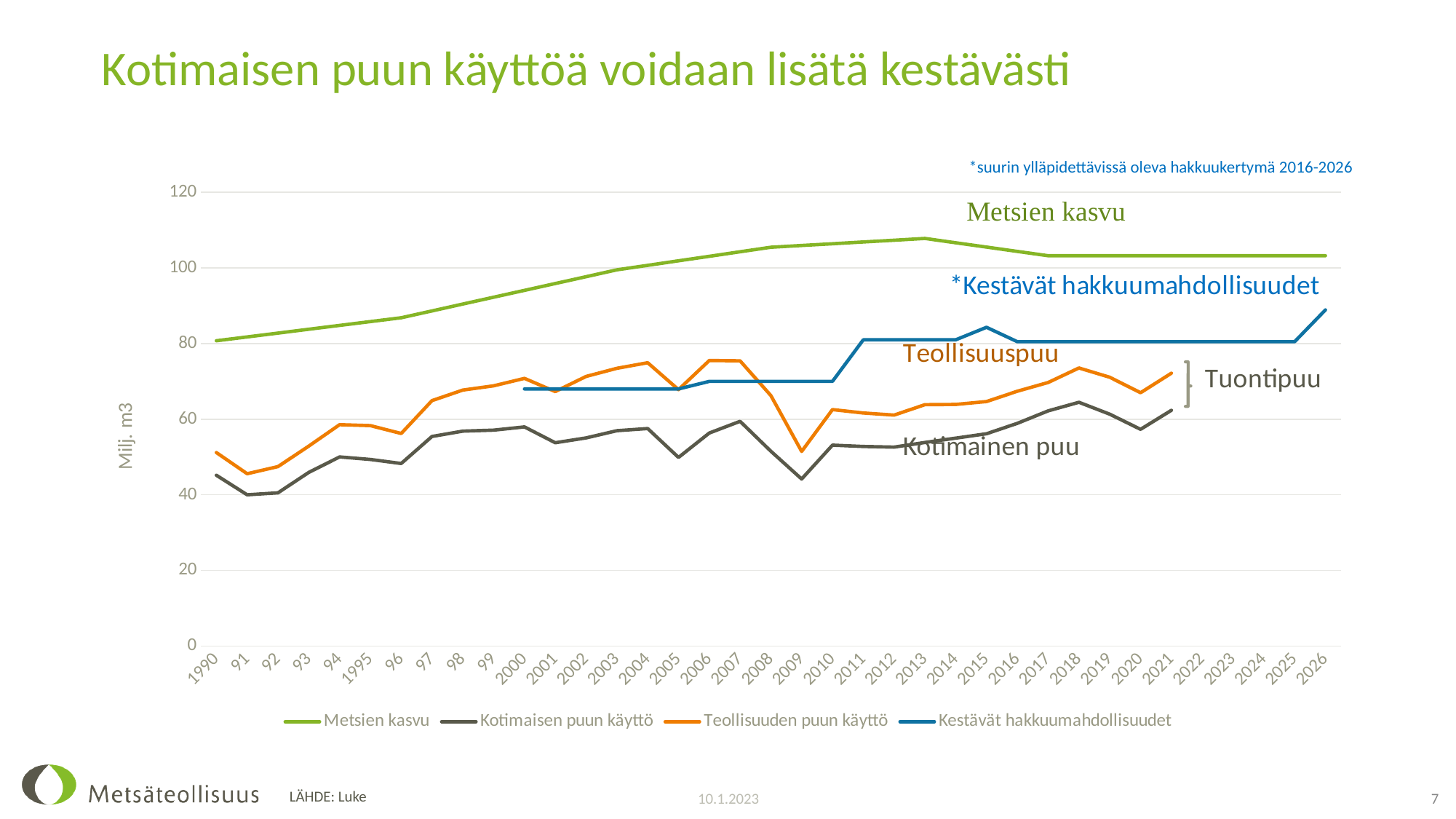
Does Metsien kasvu rise or fall from 1990 to 2013? rise In 2015, which is higher: Metsien kasvu or Kestävät hakkuumahdollisuudet? Metsien kasvu Is the value for Metsien kasvu in 2026 greater or less than 100? greater Is the value for Kotimaisen puun käyttö in 2009 greater or less than 60? less Is the value for Teollisuuden puun käyttö in 2009 greater or less than 60? less How many series does the legend list? 4 In 2021, which is higher: Teollisuuden puun käyttö or Kotimaisen puun käyttö? Teollisuuden puun käyttö Which series is drawn in green according to the legend? Metsien kasvu In which year is Teollisuuden puun käyttö at its lowest? 1991 What is the label on the vertical axis? Milj. m3 What kind of chart is shown on the slide? line chart